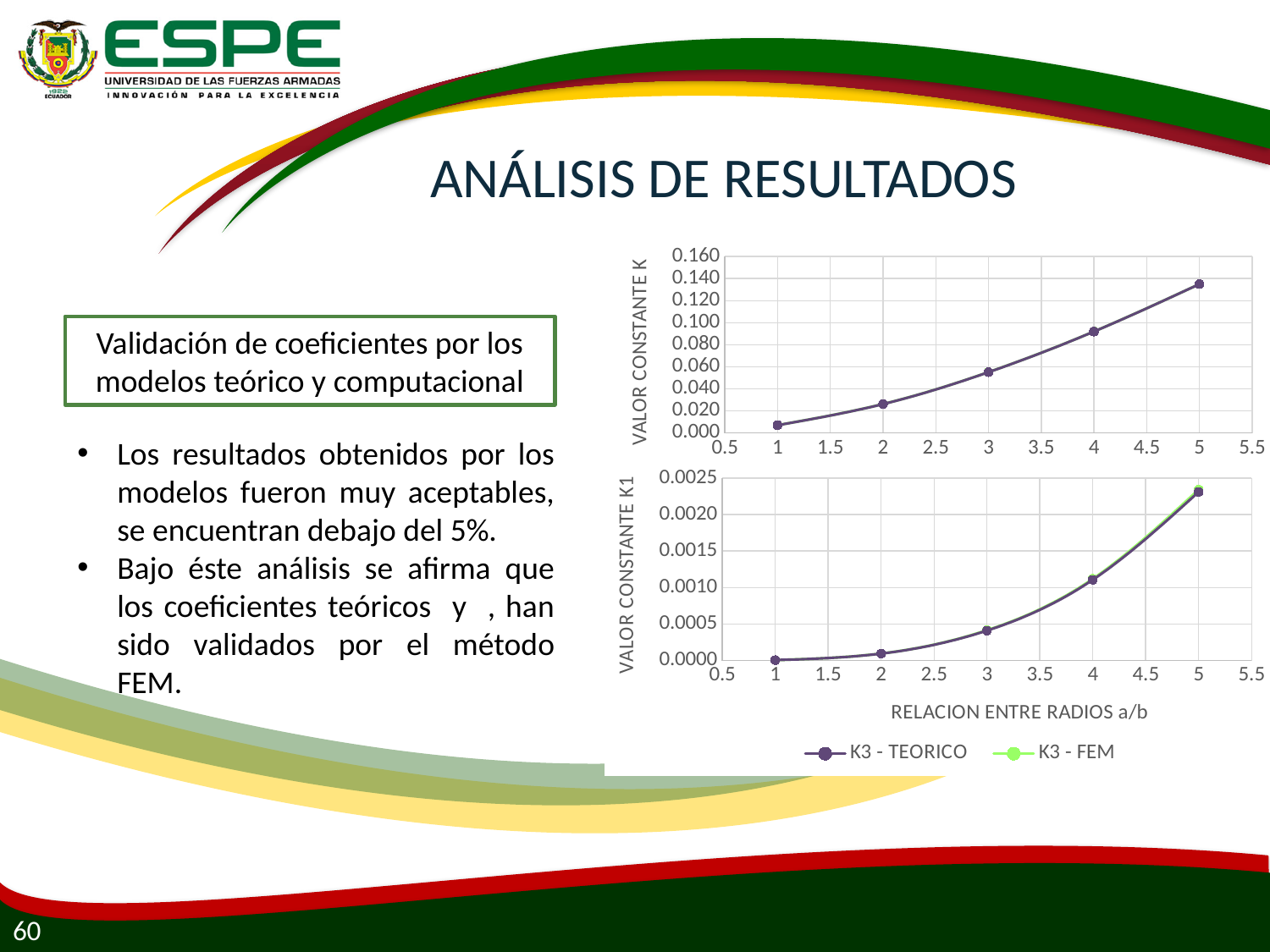
In the top chart (VALOR CONSTANTE K), is the value at a/b = 5 greater or less than 0.120? greater In the top chart (VALOR CONSTANTE K), how many data points are plotted along the x axis? 5 In the top chart (VALOR CONSTANTE K), is the value at a/b = 2 greater or less than 0.040? less In the bottom chart (VALOR CONSTANTE K1), is the value at a/b = 5 greater or less than 0.0020? greater What are the two series named in the legend? K3 - TEORICO and K3 - FEM In the top chart (VALOR CONSTANTE K), at which a/b value is the constant K highest? 5 What kind of chart is the top chart (VALOR CONSTANTE K)? line chart In the top chart (VALOR CONSTANTE K), do the values rise or fall as the relation a/b increases? rise How many series does the legend list? 2 In the bottom chart (VALOR CONSTANTE K1), which is larger: the value at a/b = 4 or at a/b = 2? a/b = 4 In the bottom chart (VALOR CONSTANTE K1), at which a/b value is the constant K1 lowest? 1